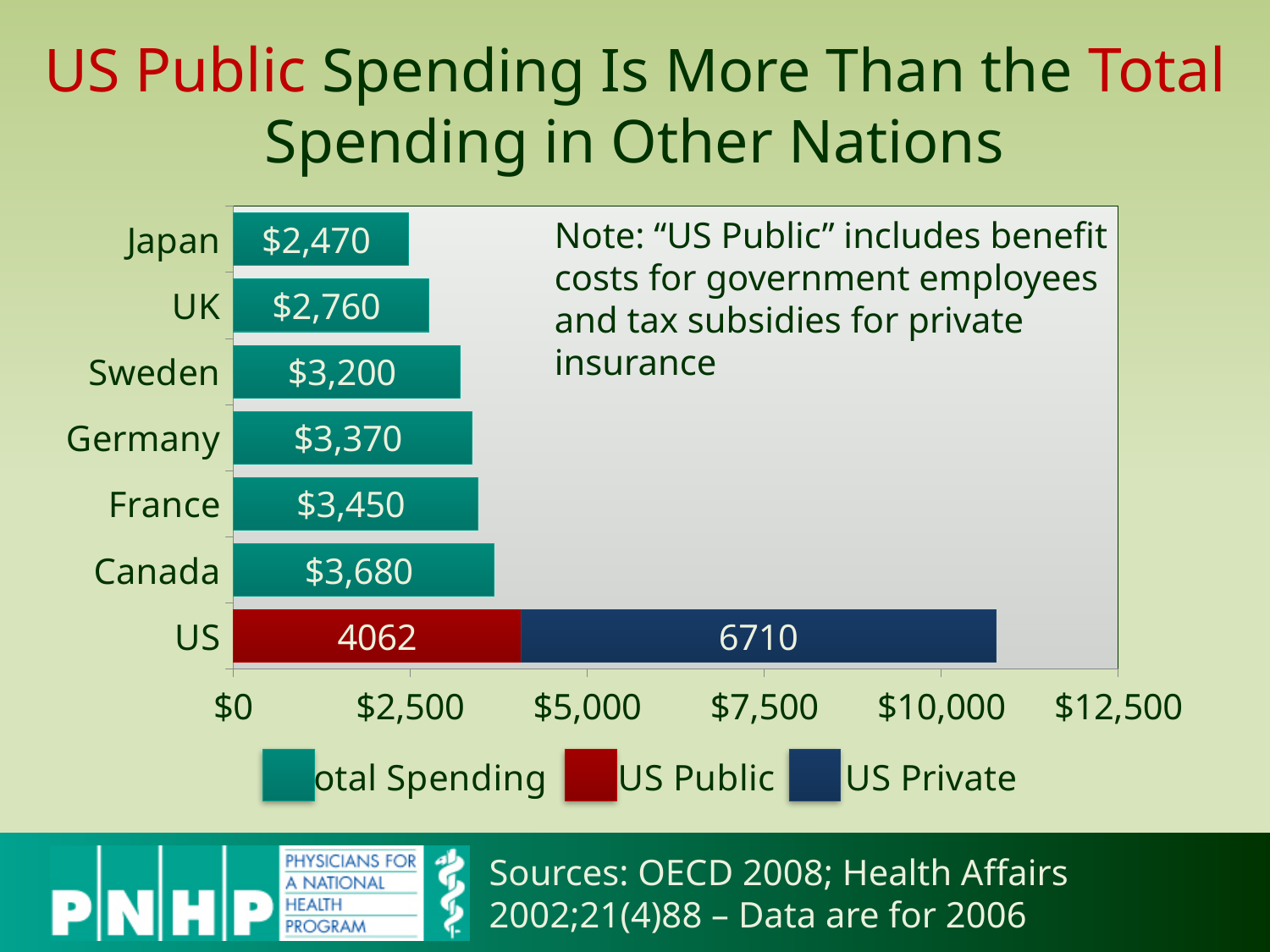
Which has a larger total spending value, Sweden or the UK? Sweden What is the total spending value shown for Canada? $3,680 Which country has the lowest total spending shown on the chart? Japan Is the total spending for Japan greater or less than $2,500? less What kind of chart is shown on the slide? bar chart How many countries are shown on the chart? 7 How many series does the legend list? 3 What is the US Public spending value shown on the chart? 4062 What is the total of the US bar (US Public plus US Private)? 10772 What is the difference between the total spending of France and Germany? $80 What is the US Private spending value shown on the chart? 6710 Among the countries other than the US, which has the highest total spending? Canada